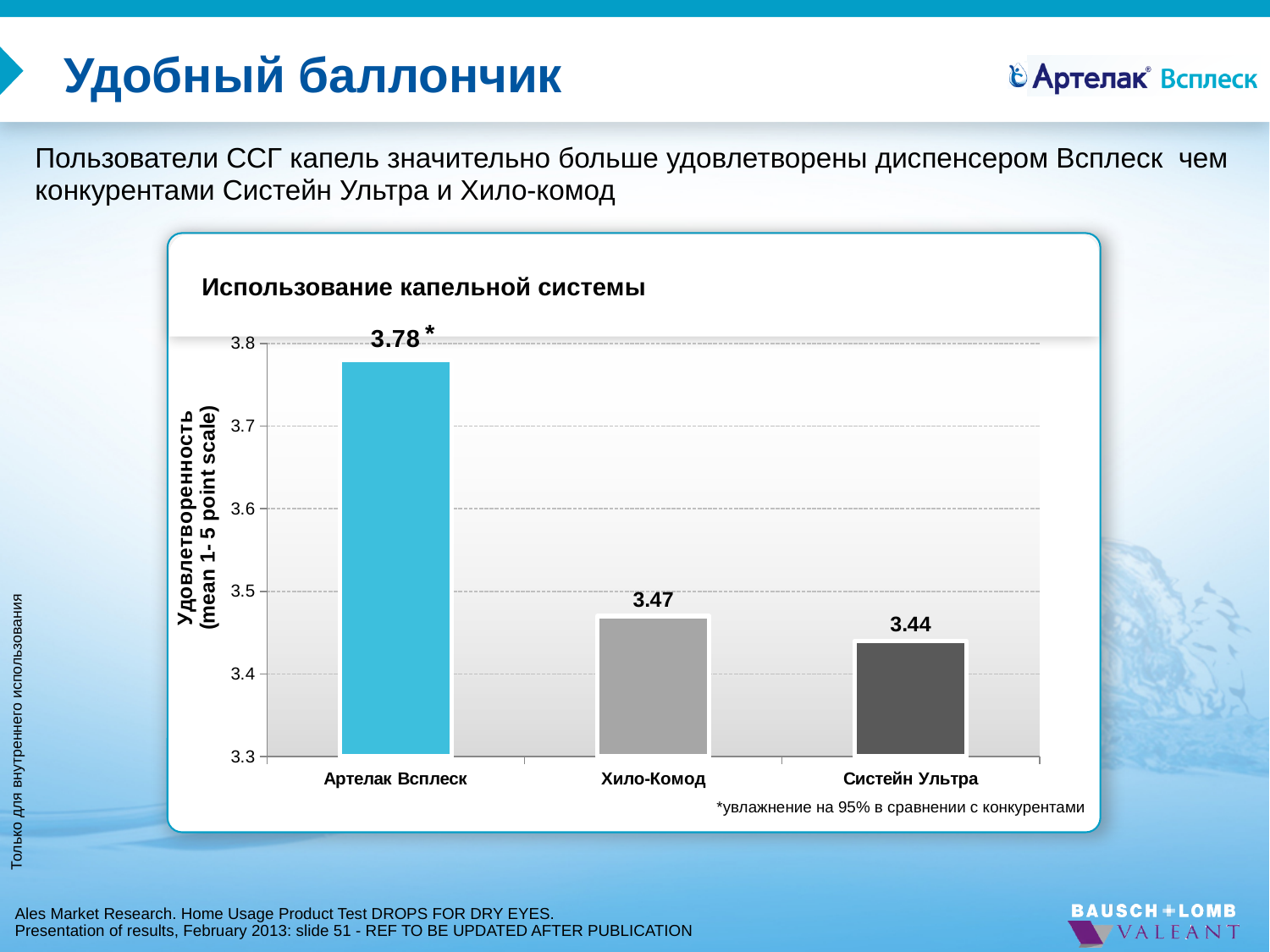
How many categories are shown in the chart? 3 What kind of chart is shown on the slide? bar chart What is the difference between the values for Хило-Комод and Систейн Ультра? 0.03 What is the value for Систейн Ультра? 3.44 Which category has the lowest value? Систейн Ультра Which category has the highest value? Артелак Всплеск What is the difference between the values for Артелак Всплеск and Хило-Комод? 0.31 Is the value for Хило-Комод greater or less than 3.5? less Which is larger, the value for Артелак Всплеск or the value for Систейн Ультра? Артелак Всплеск What is the value for Хило-Комод? 3.47 What is the title of the chart? Использование капельной системы What is the value for Артелак Всплеск? 3.78